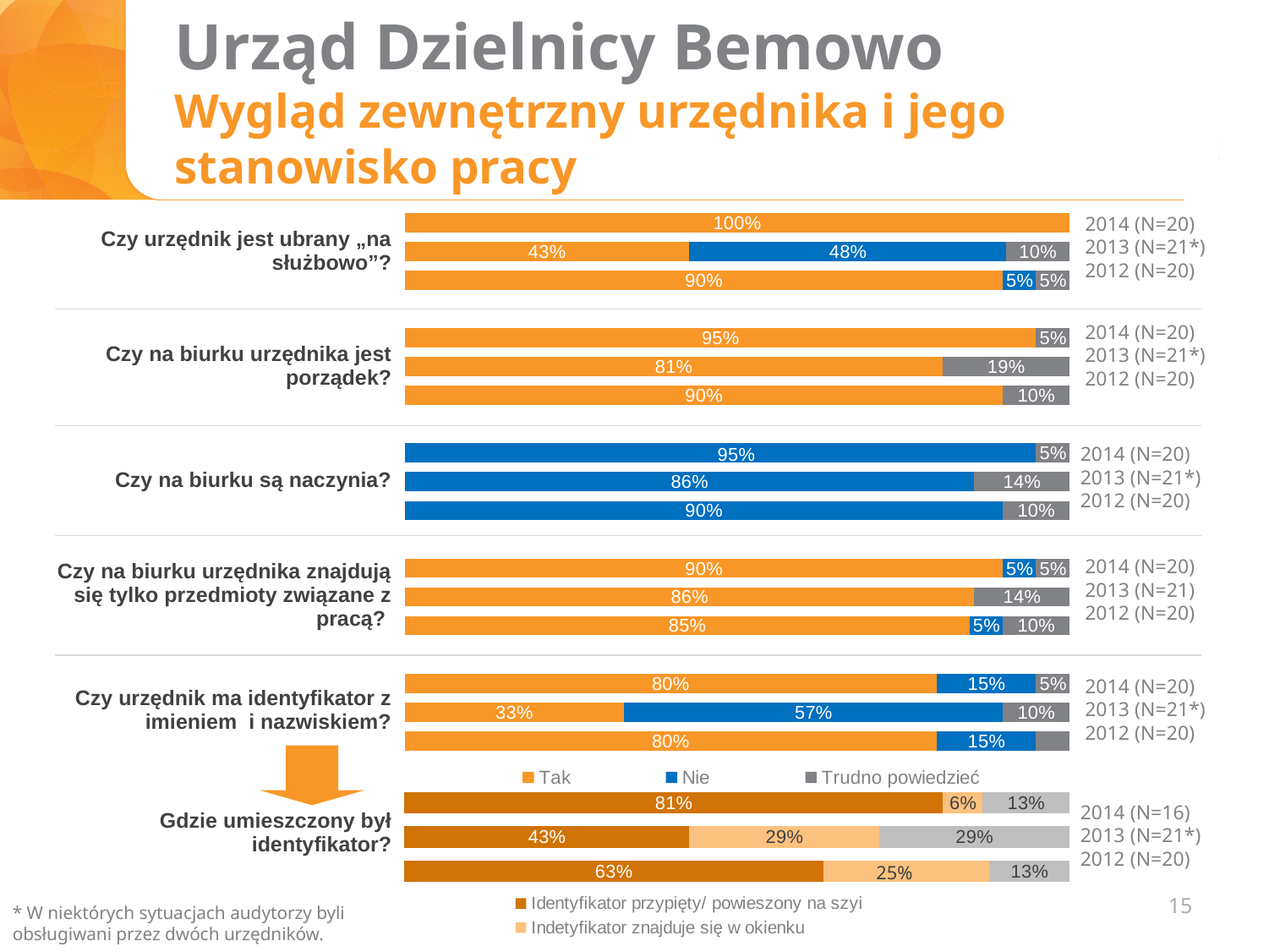
In the chart for "Czy na biurku urzędnika jest porządek?", which year has the lowest "Tak" share? 2013 In the chart for "Czy urzędnik ma identyfikator z imieniem i nazwiskiem?", which is larger in 2013: the "Tak" share or the "Nie" share? Nie How many series does the legend with "Tak", "Nie" and "Trudno powiedzieć" list? 3 In the chart for "Gdzie umieszczony był identyfikator?", which year has the highest share for "Identyfikator przypięty/ powieszony na szyi"? 2014 In the chart for "Czy na biurku są naczynia?", what share answered "Nie" in 2013? 86% In the chart for "Czy urzędnik jest ubrany „na służbowo”?", what share answered "Tak" in 2014? 100% In the chart for "Czy na biurku urzędnika znajdują się tylko przedmioty związane z pracą?", what share answered "Tak" in 2012? 85% In the chart for "Czy na biurku urzędnika jest porządek?", what is the difference between the "Tak" share in 2014 and in 2013? 14 percentage points In the chart for "Czy urzędnik jest ubrany „na służbowo”?", what share answered "Nie" in 2013? 48% In the chart for "Gdzie umieszczony był identyfikator?", what share in 2012 had the identifier pinned/hung around the neck ("Identyfikator przypięty/ powieszony na szyi")? 63% What type of chart is used on this slide? Stacked bar chart In the chart for "Czy urzędnik ma identyfikator z imieniem i nazwiskiem?", what share answered "Nie" in 2014? 15%